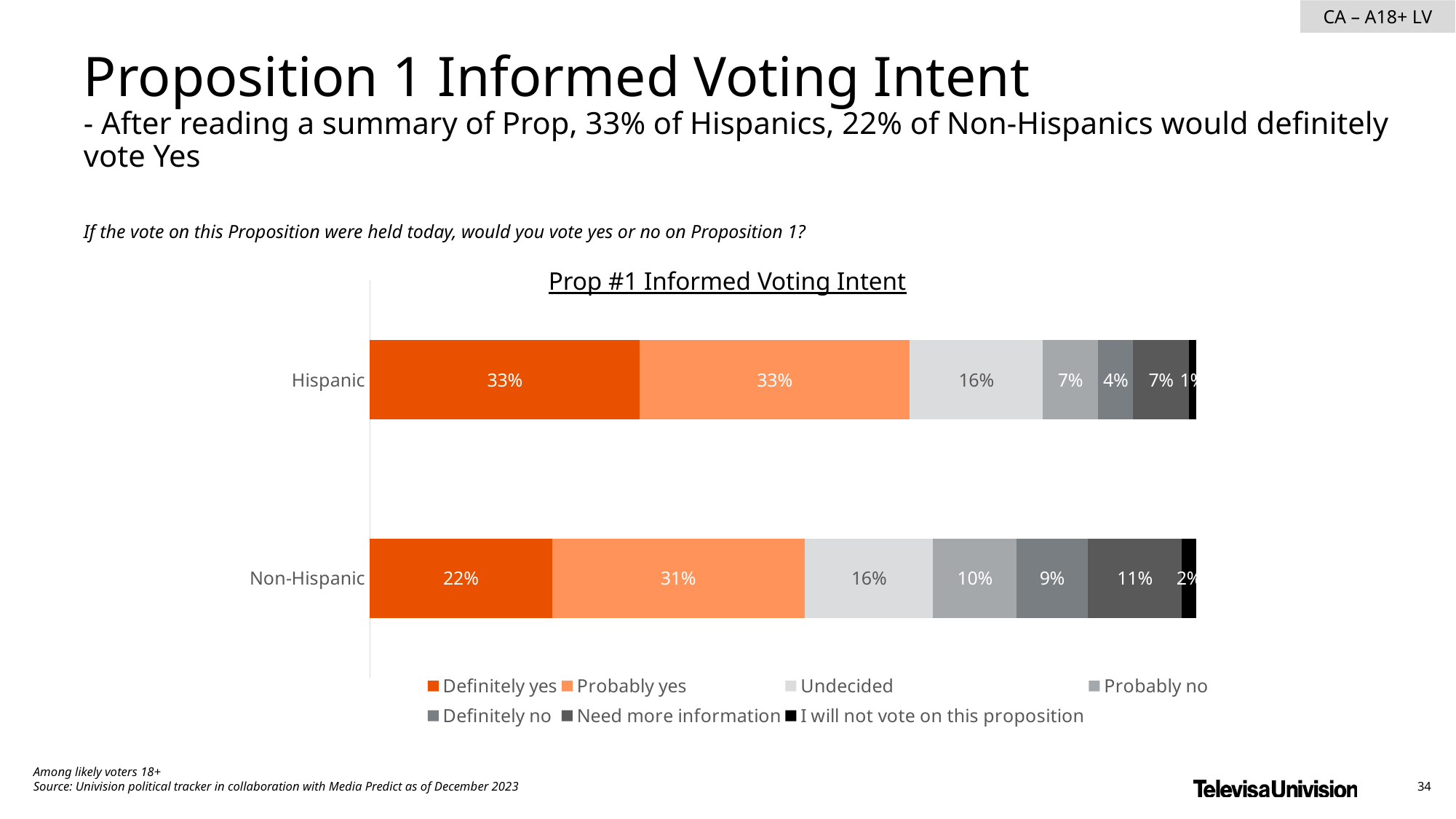
What percentage of Hispanic likely voters would definitely vote yes on Proposition 1? 33% What type of chart is shown on the slide? Stacked bar chart What is the 'Need more information' value for Non-Hispanic voters? 11% What share of Hispanic voters are undecided on Proposition 1? 16% What percentage of Non-Hispanic likely voters would definitely vote yes on Proposition 1? 22% What is the 'Definitely no' value for Hispanic voters? 4% What is the difference between the 'Definitely yes' values for Hispanic and Non-Hispanic voters? 11 percentage points What is the 'Probably yes' value for Non-Hispanic voters? 31% Which group has a higher 'Probably no' value, Hispanic or Non-Hispanic? Non-Hispanic How many series does the legend list? 7 Which group has a higher 'Definitely yes' value, Hispanic or Non-Hispanic? Hispanic How many groups (bars) are shown in the chart? 2